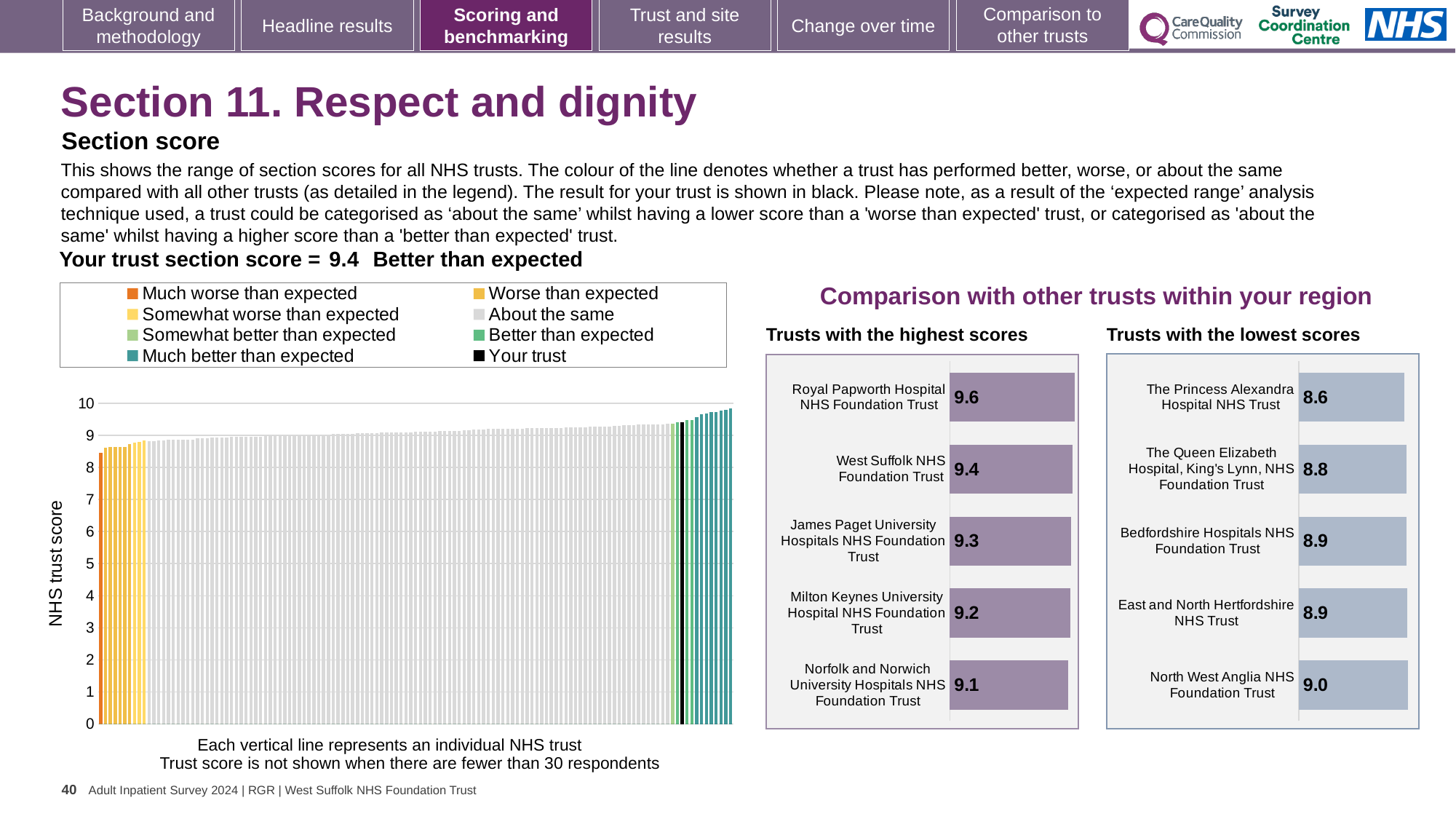
In the large 'NHS trust score' chart on the left, is the value for your trust (the black bar) greater or less than 9? greater How many entries does the legend above the large 'NHS trust score' chart list? 8 In the 'Trusts with the highest scores' chart, what is the score for Royal Papworth Hospital NHS Foundation Trust? 9.6 What kind of chart is the large 'NHS trust score' chart on the left of the slide? Bar chart In the 'Trusts with the highest scores' chart, what is the score for Norfolk and Norwich University Hospitals NHS Foundation Trust? 9.1 In the 'Trusts with the lowest scores' chart, which has the larger score: Bedfordshire Hospitals NHS Foundation Trust or The Princess Alexandra Hospital NHS Trust? Bedfordshire Hospitals NHS Foundation Trust In the large 'NHS trust score' chart on the left, do the values rise or fall from left to right? Rise In the 'Trusts with the highest scores' chart, what is the difference between the scores of Royal Papworth Hospital NHS Foundation Trust and West Suffolk NHS Foundation Trust? 0.2 In the 'Trusts with the lowest scores' chart, what is the score for North West Anglia NHS Foundation Trust? 9.0 In the 'Trusts with the highest scores' chart, which trust has the highest score? Royal Papworth Hospital NHS Foundation Trust How many trusts are shown in the 'Trusts with the highest scores' chart? 5 In the 'Trusts with the lowest scores' chart, which trust has the lowest score? The Princess Alexandra Hospital NHS Trust